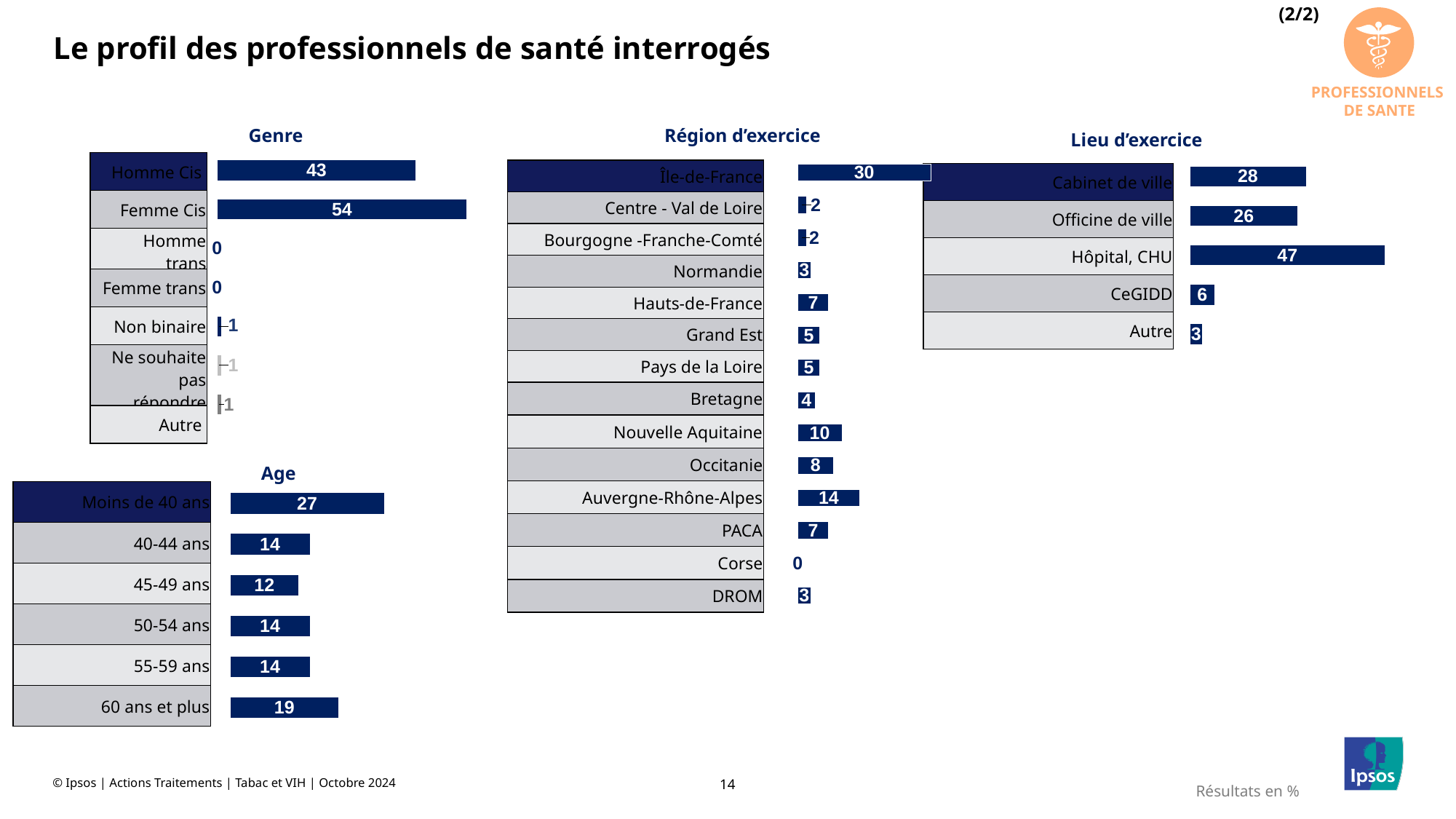
In the 'Lieu d'exercice' chart, what is the value for Hôpital, CHU? 47 In the 'Région d'exercice' chart, what is the value for Auvergne-Rhône-Alpes? 14 In the 'Région d'exercice' chart, how many regions are listed? 14 In the 'Age' chart, what is the value for 60 ans et plus? 19 In the 'Région d'exercice' chart, which region has the highest value? Île-de-France What type of chart is used for 'Lieu d'exercice'? Bar chart In the 'Lieu d'exercice' chart, which category has the lowest value? Autre In the 'Région d'exercice' chart, which is larger, Nouvelle Aquitaine or Occitanie? Nouvelle Aquitaine In the 'Age' chart, which age group has the highest value? Moins de 40 ans In the 'Genre' chart, what is the difference between Femme Cis and Homme Cis? 11 In the 'Genre' chart, what is the value for Femme Cis? 54 In the 'Age' chart, how many age categories are shown? 6